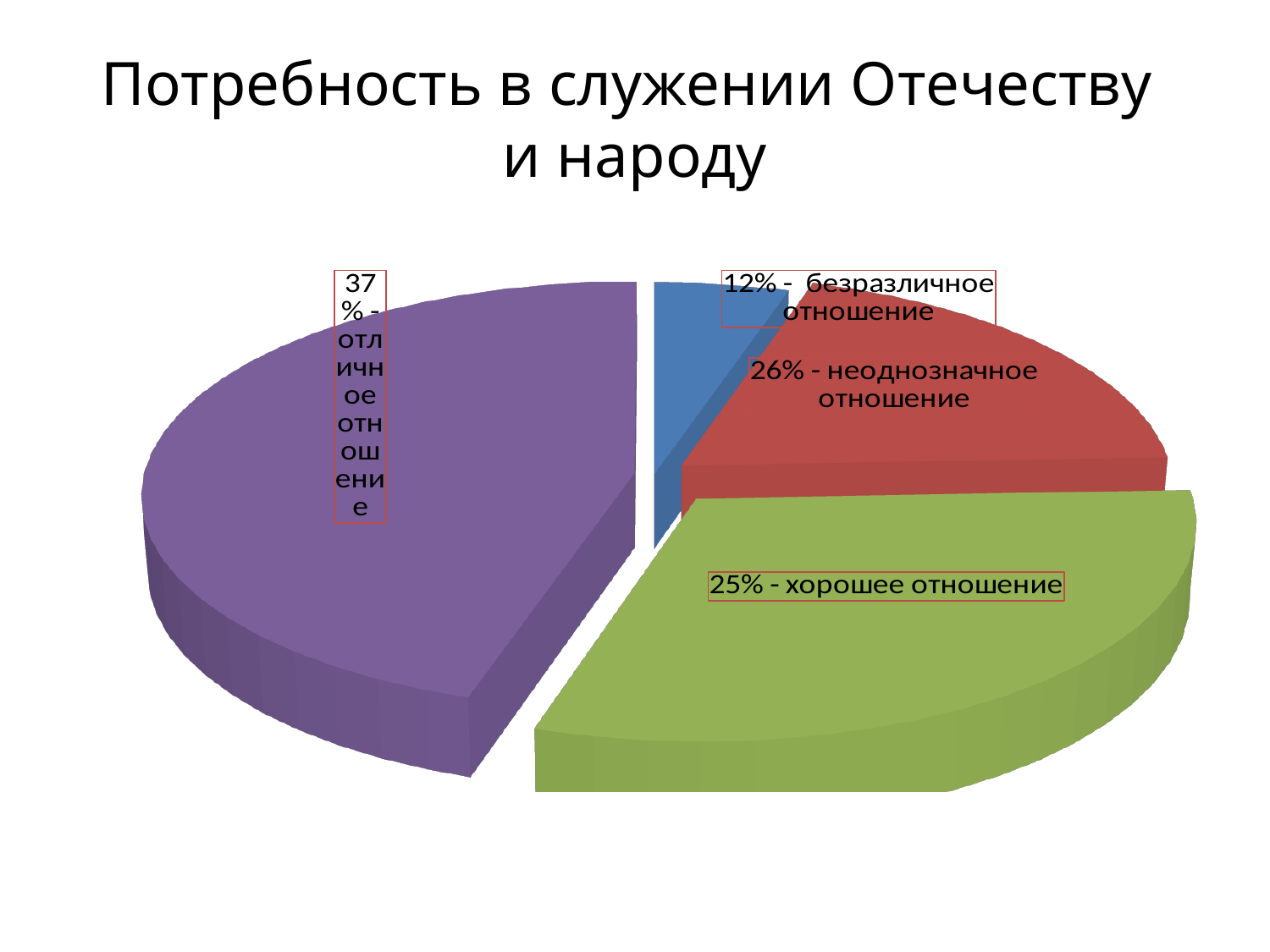
What share of the pie is labelled "хорошее отношение"? 25% Which category has the smallest slice of the pie? безразличное отношение What share of the pie is labelled "отличное отношение"? 37% How many slices does the pie chart have? 4 Which is larger: the slice for "неоднозначное отношение" or the slice for "безразличное отношение"? неоднозначное отношение What kind of chart is shown on the slide? pie chart Which category has the largest slice of the pie? отличное отношение What share of the pie is labelled "неоднозначное отношение"? 26% What colour is the slice for "хорошее отношение"? green What is the difference in percentage points between "отличное отношение" and "безразличное отношение"? 25 What is the title of the slide's chart? Потребность в служении Отечеству и народу